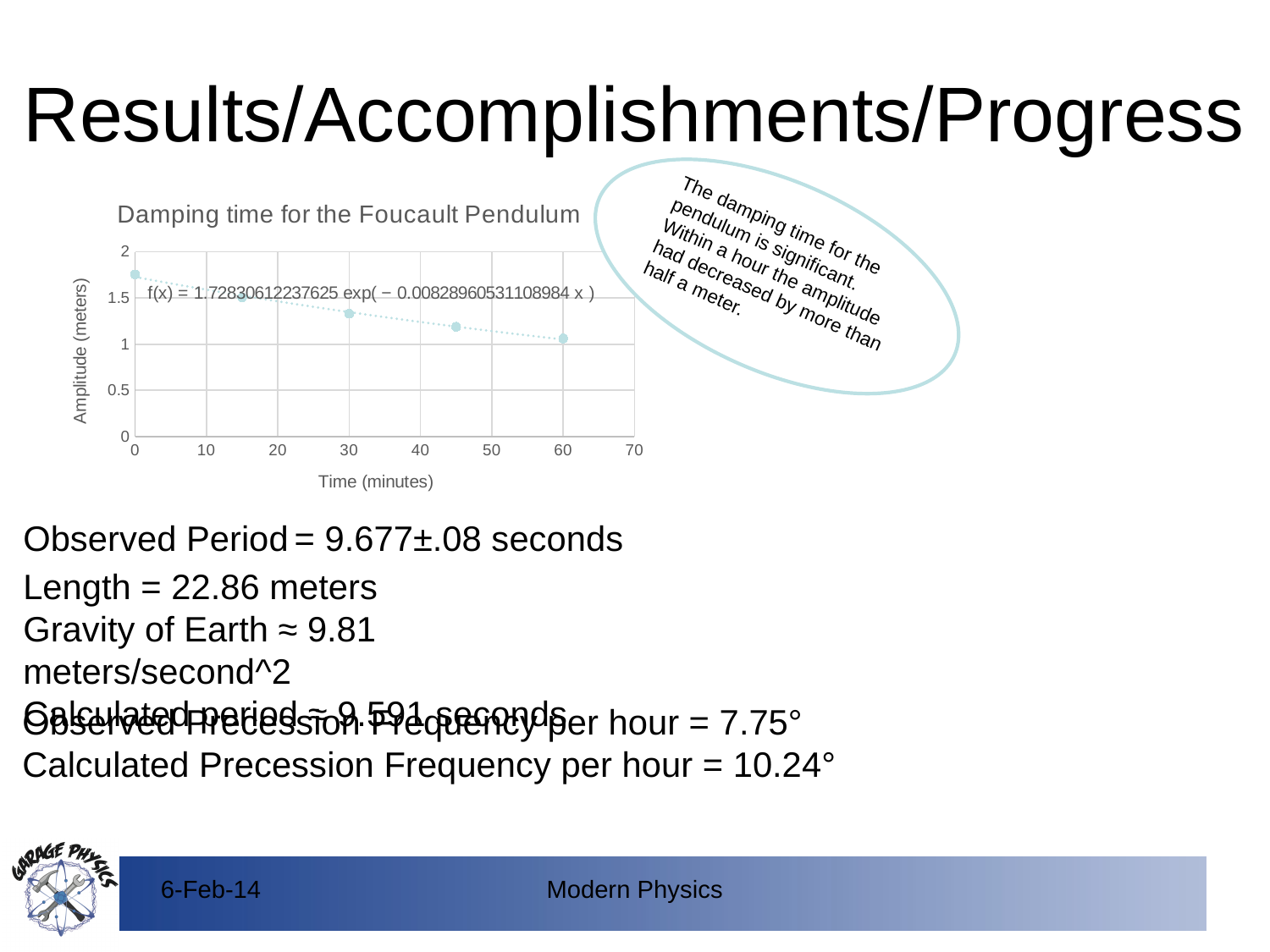
Is the amplitude at time 60 minutes greater or less than 1.5? less What kind of chart is shown on the slide? scatter chart How many data points are plotted in the chart? 5 Is the amplitude at time 45 minutes greater or less than 1.5? less What is the label of the vertical axis of the chart? Amplitude (meters) At which time (in minutes) is the amplitude highest? 0 Is the amplitude at time 30 minutes greater or less than 1? greater At which time (in minutes) is the amplitude lowest? 60 Which has the larger amplitude: the point at 0 minutes or the point at 60 minutes? 0 minutes What is the title of the chart? Damping time for the Foucault Pendulum Do the amplitude values rise or fall as time increases along the x axis? fall